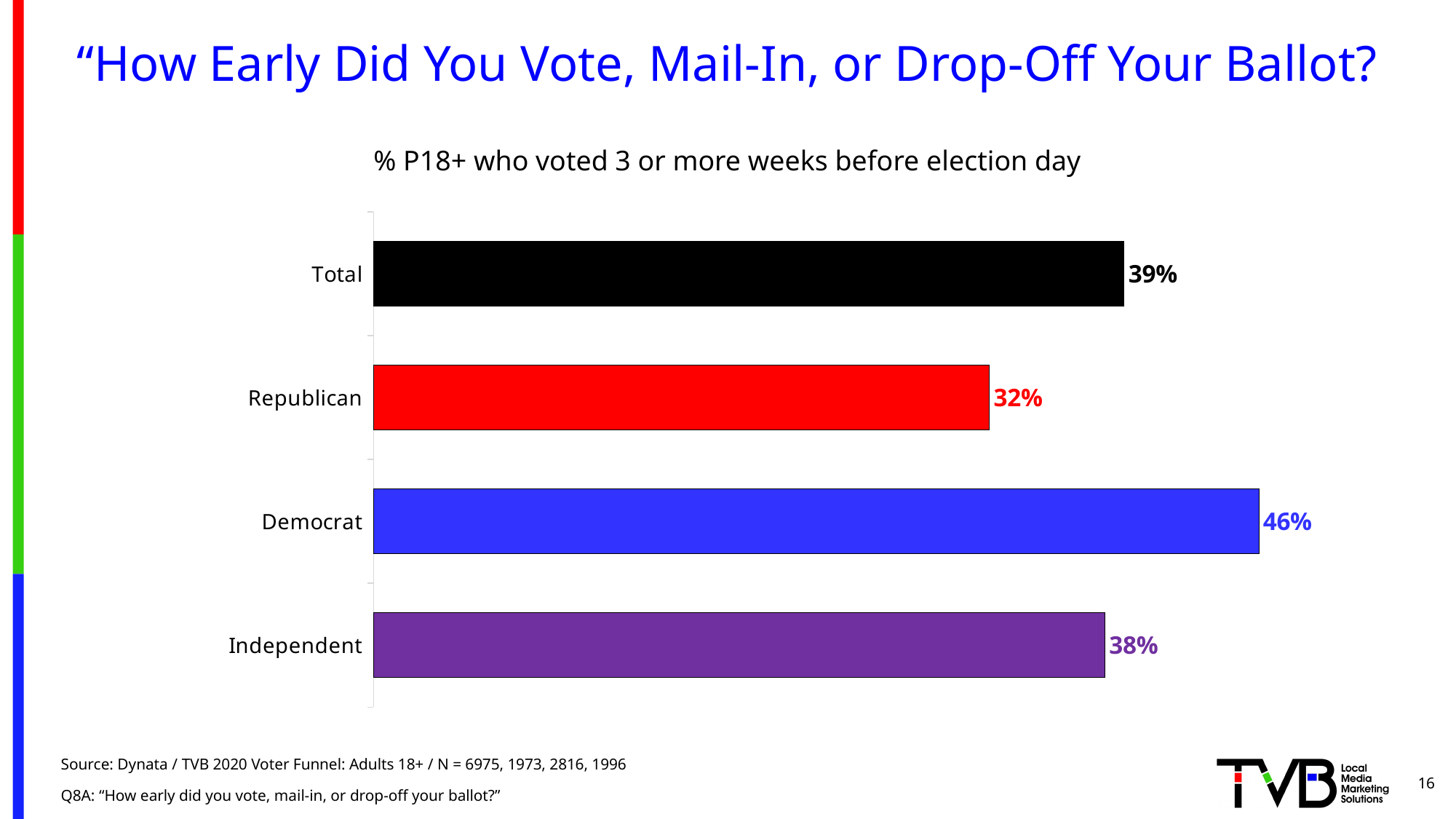
What is the value shown for Republican? 32% What colour is the bar for Independent? Purple What is the value shown for Total? 39% How many categories are shown in the chart? 4 Which is larger, the value for Democrat or the value for Total? Democrat Which category has the highest percentage? Democrat What is the value shown for Independent? 38% What is the difference in percentage points between Democrat and Republican? 14 What percentage of Democrats voted 3 or more weeks before election day? 46% Which category has the lowest percentage? Republican What is the difference in percentage points between Total and Independent? 1 What kind of chart is shown on the slide? Bar chart